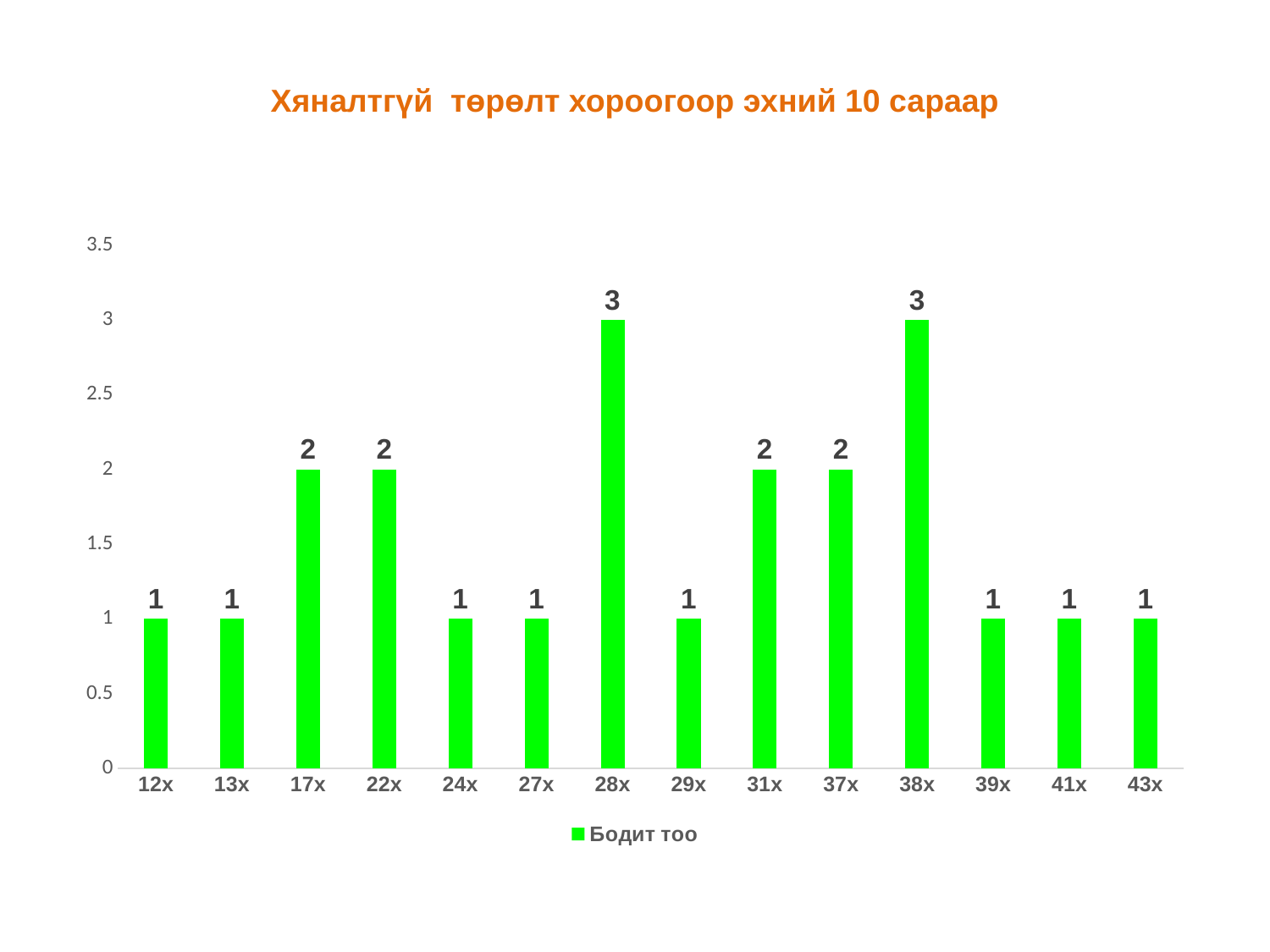
What is the value for 28х? 3 How many series does the legend list? 1 What is the difference between the values for 31х and 39х? 1 What is the value for 37х? 2 Which categories have the highest value? 28х and 38х What is the value for 17х? 2 What is the title of the chart? Хяналтгүй төрөлт хороогоор эхний 10 сараар What kind of chart is shown on the slide? Bar chart What is the difference between the values for 38х and 29х? 2 How many categories are shown on the x axis? 14 What is the value for 43х? 1 Which is larger, the value for 22х or the value for 24х? 22х